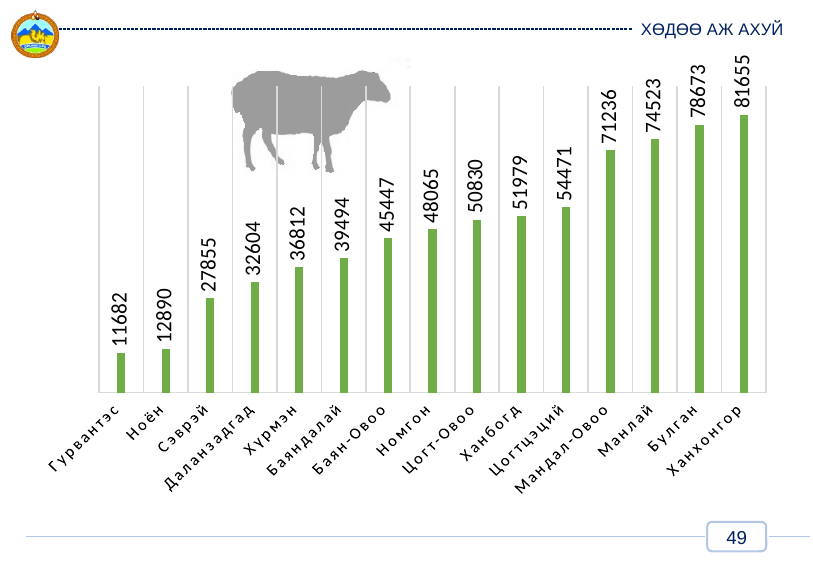
Which category has the highest value? Ханхонгор What is the value for Даланзадгад? 32604 What is the value for Цогтцэций? 54471 What is the value for Ханхонгор? 81655 Which is larger, the value for Мандал-Овоо or the value for Цогтцэций? Мандал-Овоо What kind of chart is shown on the slide? bar chart Which category has the lowest value? Гурвантэс What is the difference between the values for Булган and Манлай? 4150 Do the values rise or fall from left to right along the x axis? rise How many categories are shown on the chart? 15 What animal is pictured above the bars on the chart? a sheep What is the difference between the values for Ханхонгор and Гурвантэс? 69973